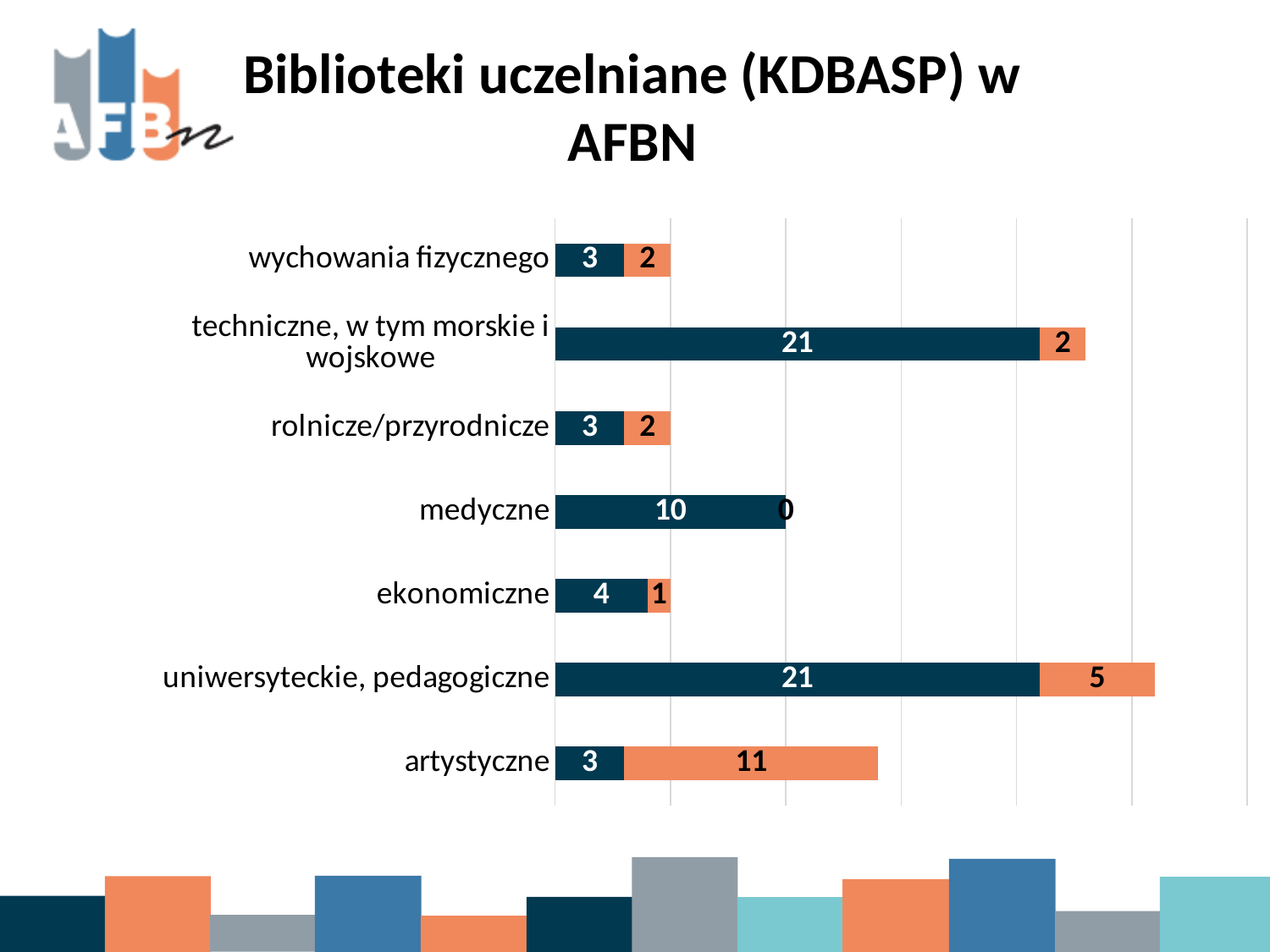
What is the value of the orange segment for "artystyczne"? 11 What is the total of the stacked bar for "techniczne, w tym morskie i wojskowe"? 23 What kind of chart is shown on the slide? Stacked bar chart Which category has the largest orange segment? artystyczne Which category has the smallest orange segment? medyczne What is the value of the dark blue segment for "medyczne"? 10 What is the value of the orange segment for "ekonomiczne"? 1 How many categories are shown on the chart? 7 What is the value of the dark blue segment for "uniwersyteckie, pedagogiczne"? 21 What is the total of the stacked bar for "uniwersyteckie, pedagogiczne"? 26 What is the difference between the dark blue segment and the orange segment for "artystyczne"? 8 Which is larger: the orange segment for "uniwersyteckie, pedagogiczne" or the orange segment for "techniczne, w tym morskie i wojskowe"? uniwersyteckie, pedagogiczne